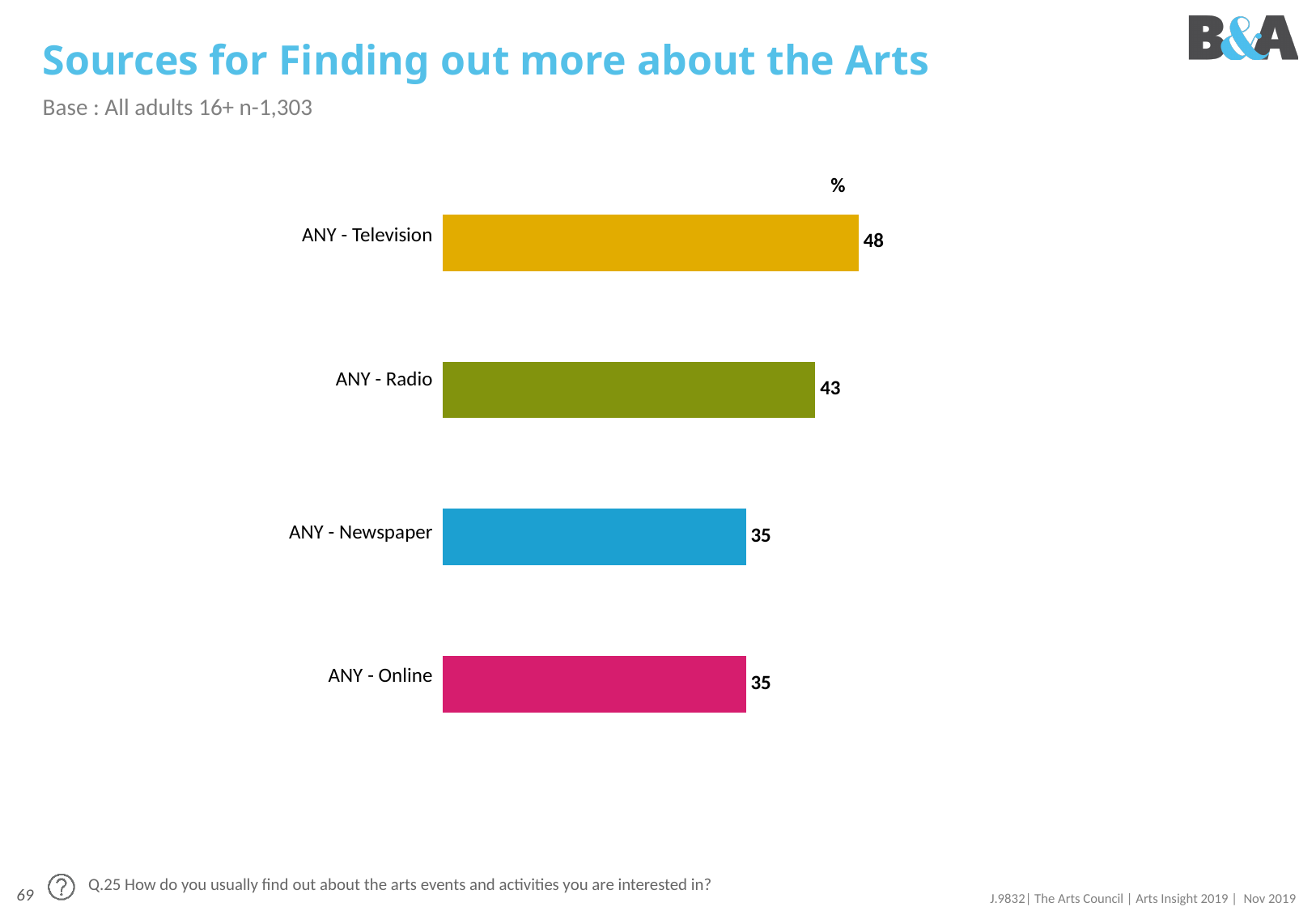
What kind of chart is shown on the slide? Bar chart What is the value for ANY - Radio? 43 What is the value for ANY - Newspaper? 35 What is the difference between the values for ANY - Television and ANY - Radio? 5 How many categories are shown in the chart? 4 What is the title of the slide? Sources for Finding out more about the Arts What is the difference between the values for ANY - Radio and ANY - Newspaper? 8 What is the value for ANY - Television? 48 What colour is the bar for ANY - Online? Pink Which category has the highest value? ANY - Television What is the value for ANY - Online? 35 Which is larger, the value for ANY - Radio or the value for ANY - Online? ANY - Radio